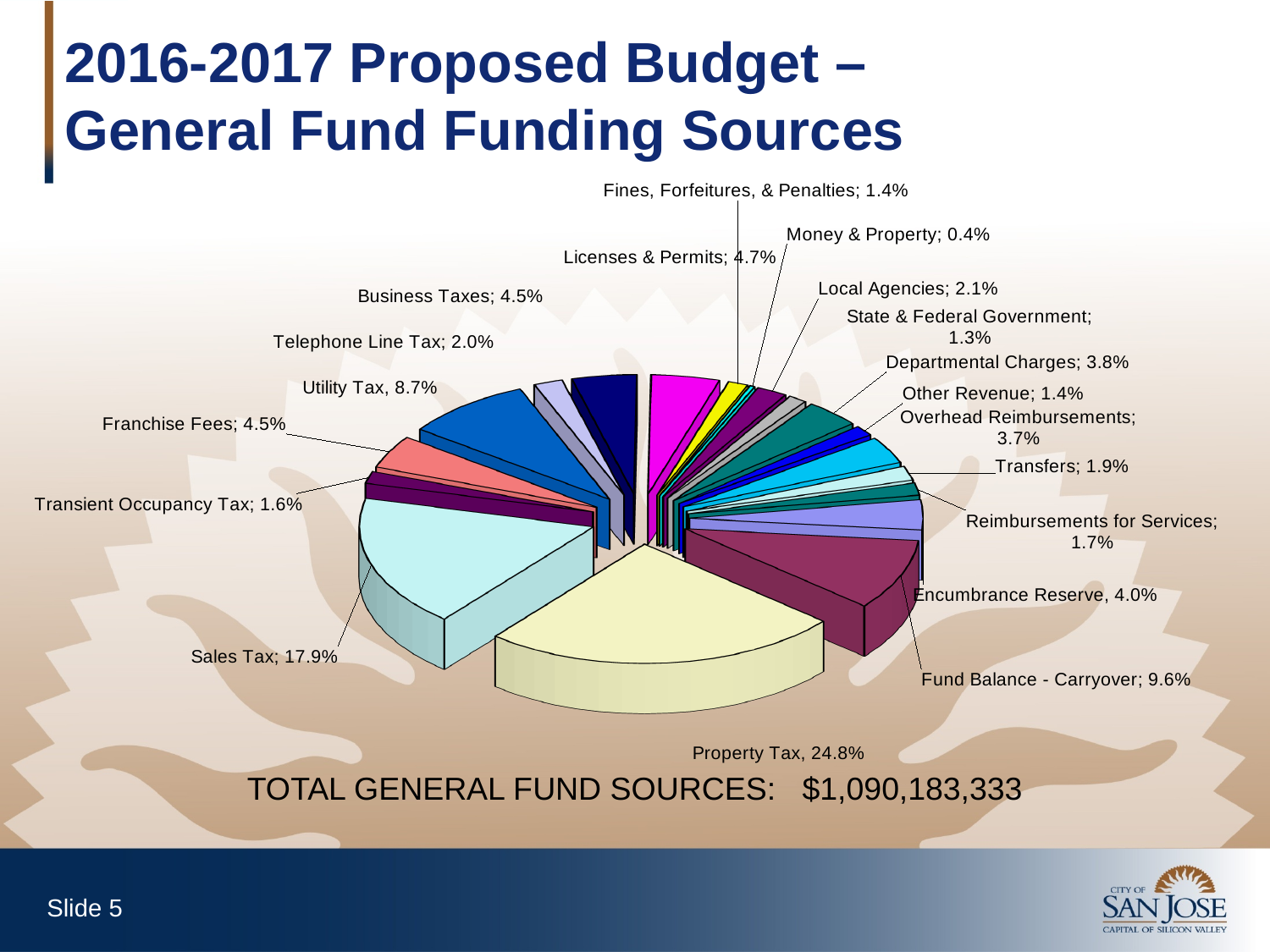
What kind of chart is shown on the slide? Pie chart What percentage is shown for Fund Balance - Carryover? 9.6% What is the title of the slide containing the pie chart? 2016-2017 Proposed Budget – General Fund Funding Sources How many funding source categories are labelled on the pie chart? 19 What is the difference in percentage points between Property Tax and Sales Tax? 6.9 Which funding source has the smallest share of the pie? Money & Property What percentage is shown for Utility Tax? 8.7% What percentage is shown for Sales Tax? 17.9% What is the total General Fund sources amount stated below the chart? $1,090,183,333 Which funding source has the largest share of the pie? Property Tax Which is larger, the share for Licenses & Permits or the share for Business Taxes? Licenses & Permits What share of General Fund sources comes from Property Tax? 24.8%